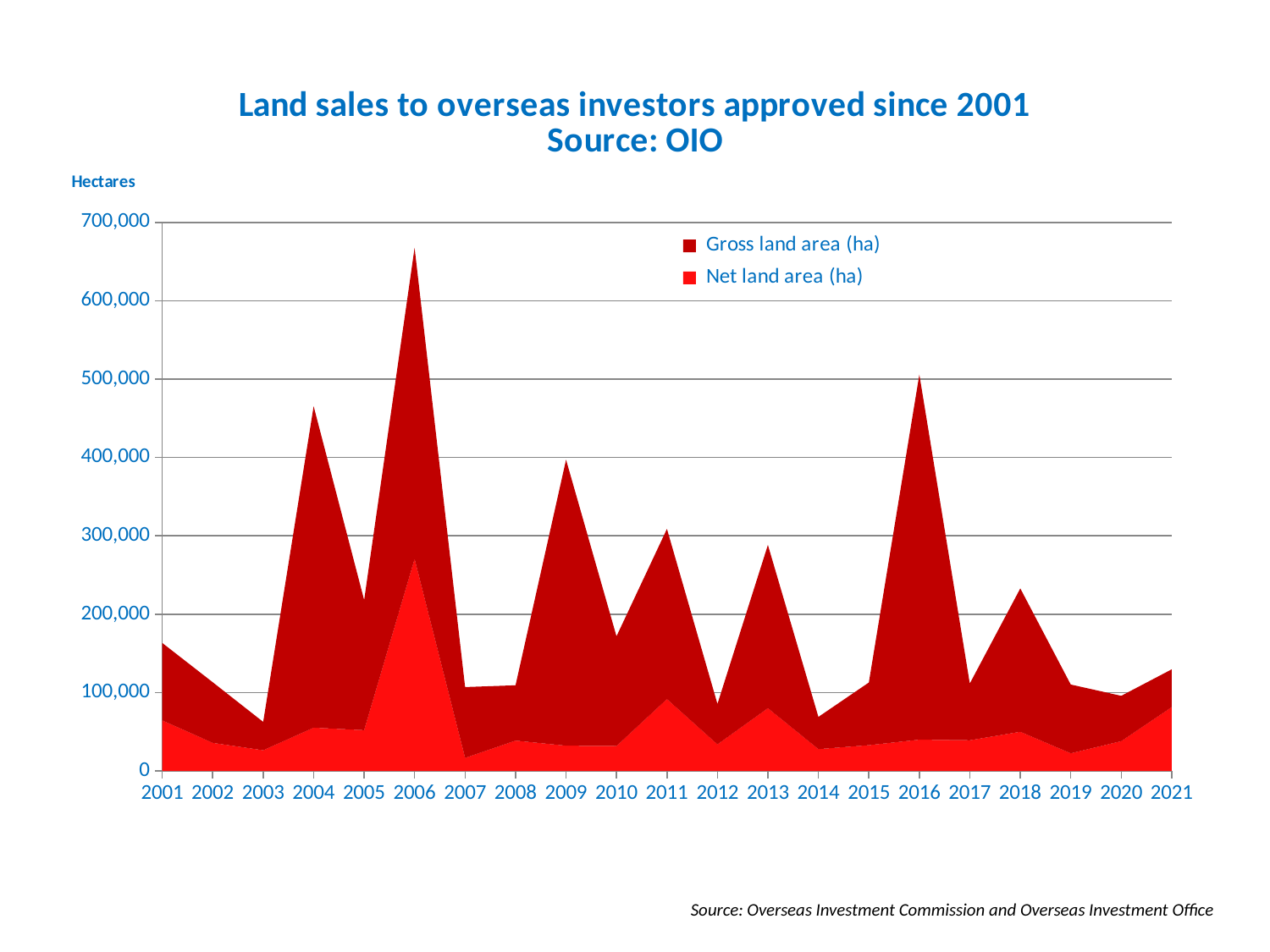
Is the Net land area (ha) for 2006 greater or less than 200,000? greater In which year is the Net land area (ha) highest? 2006 What unit is shown on the y axis label? Hectares Does the Gross land area (ha) rise or fall from 2001 to 2003? Fall Is the Gross land area (ha) for 2004 greater or less than 400,000? greater Which year has the larger Gross land area (ha), 2006 or 2016? 2006 In which year is the Gross land area (ha) highest? 2006 How many series does the legend list? 2 How many years are plotted along the x axis? 21 What kind of chart is shown on the slide? Area chart Is the Gross land area (ha) for 2006 greater or less than 600,000? greater